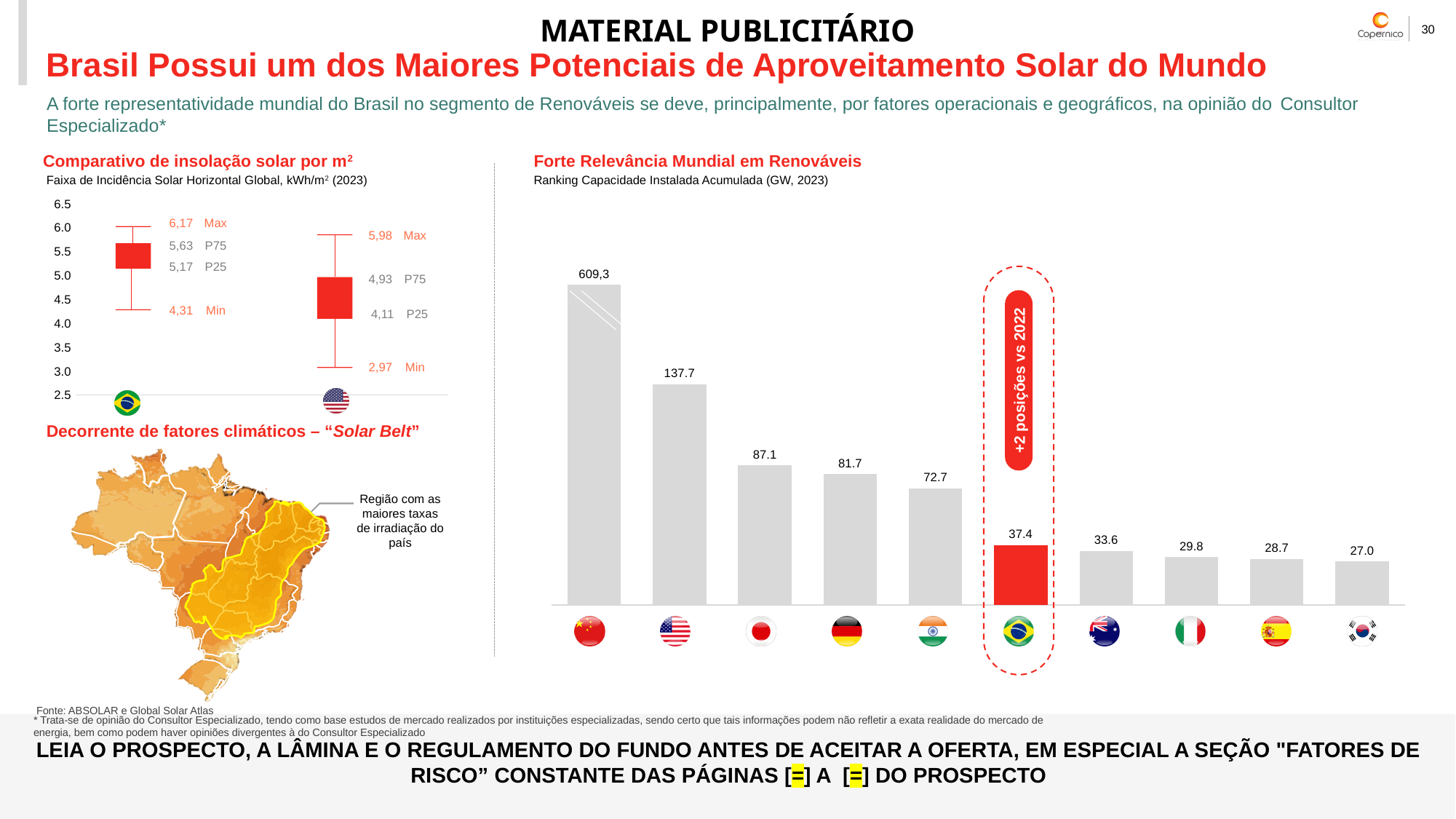
What does the red callout next to the highlighted bar in the chart 'Forte Relevância Mundial em Renováveis' say? +2 posições vs 2022 In the chart 'Comparativo de insolação solar por m²', what is the Max value for Brazil? 6,17 In the chart 'Comparativo de insolação solar por m²', what is the Min value for the United States? 2,97 In the bar chart 'Forte Relevância Mundial em Renováveis', what is the value of the first (tallest) bar, for China? 609,3 In the bar chart 'Forte Relevância Mundial em Renováveis', do the values rise or fall from left to right? Fall How many bars are shown in the bar chart 'Forte Relevância Mundial em Renováveis'? 10 In the bar chart 'Forte Relevância Mundial em Renováveis', what is the value of the lowest bar? 27.0 In the bar chart 'Forte Relevância Mundial em Renováveis', what is the value of the highlighted red bar (Brazil)? 37.4 In the bar chart 'Forte Relevância Mundial em Renováveis', which is larger: the seventh bar (Australia) or the eighth bar (Italy)? The seventh bar (Australia), 33.6 In the bar chart 'Forte Relevância Mundial em Renováveis', what is the difference between the third bar (87.1) and the fourth bar (81.7)? 5.4 What kind of chart is used under 'Forte Relevância Mundial em Renováveis'? Bar chart In the chart 'Comparativo de insolação solar por m²', which country has the higher Max value, Brazil or the United States? Brazil